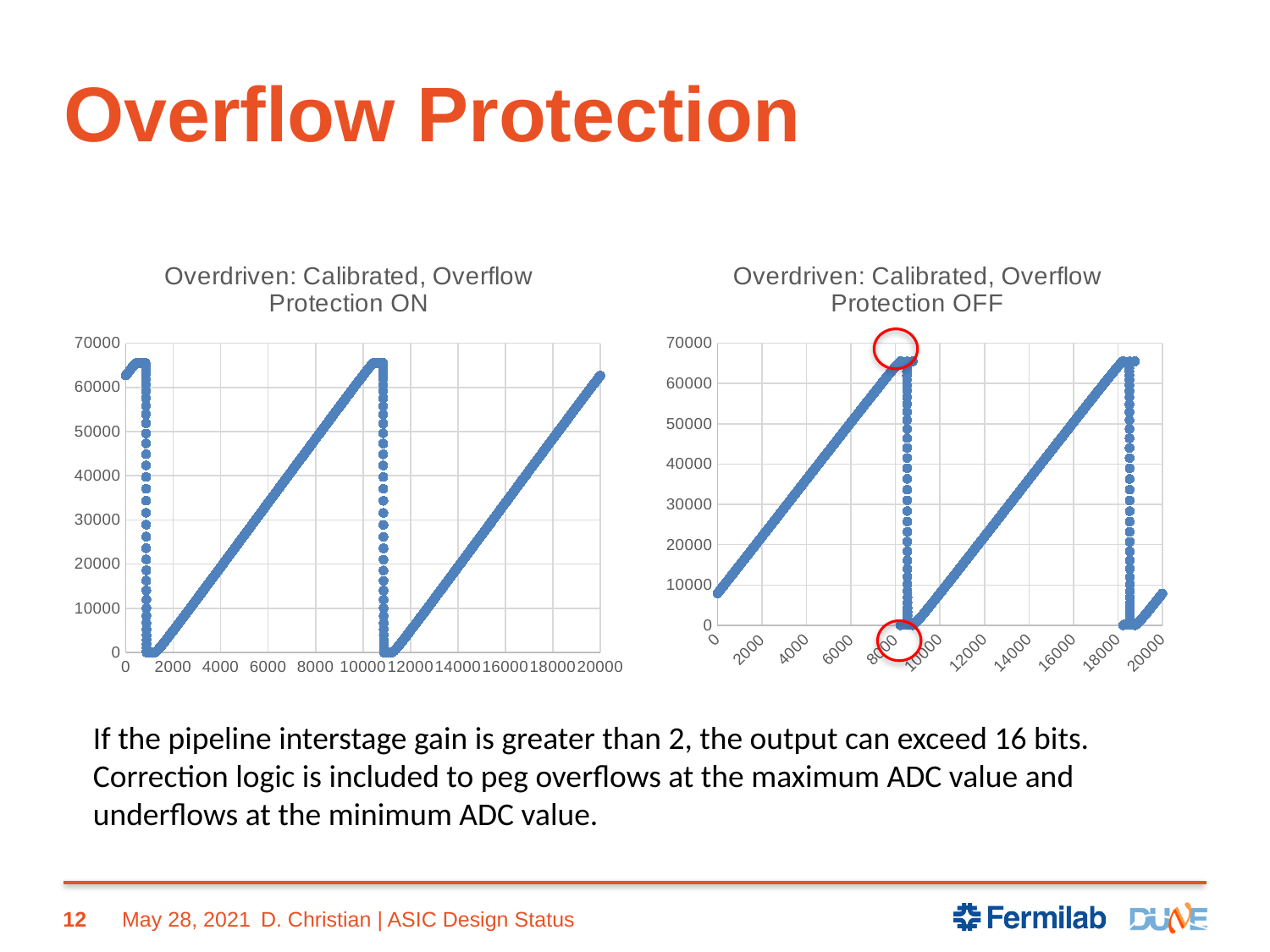
How many charts are shown on the slide? 2 In the left chart (Overflow Protection ON), what is the highest value shown on the vertical axis? 70000 In the right chart (Overflow Protection OFF), is the plotted value at x = 4000 greater or less than 20000? greater What kind of chart is the right chart titled "Overdriven: Calibrated, Overflow Protection OFF"? scatter chart In the left chart (Overflow Protection ON), is the plotted value at x = 6000 greater or less than 50000? less What kind of chart is the left chart titled "Overdriven: Calibrated, Overflow Protection ON"? scatter chart In the right chart (Overflow Protection OFF), what is the highest value shown on the horizontal axis? 20000 What is the title of the right chart? Overdriven: Calibrated, Overflow Protection OFF What is the title of the left chart? Overdriven: Calibrated, Overflow Protection ON In the left chart (Overflow Protection ON), is the plotted value at x = 6000 greater or less than 20000? greater In the left chart (Overflow Protection ON), do the plotted values rise or fall between x = 2000 and x = 10000? rise